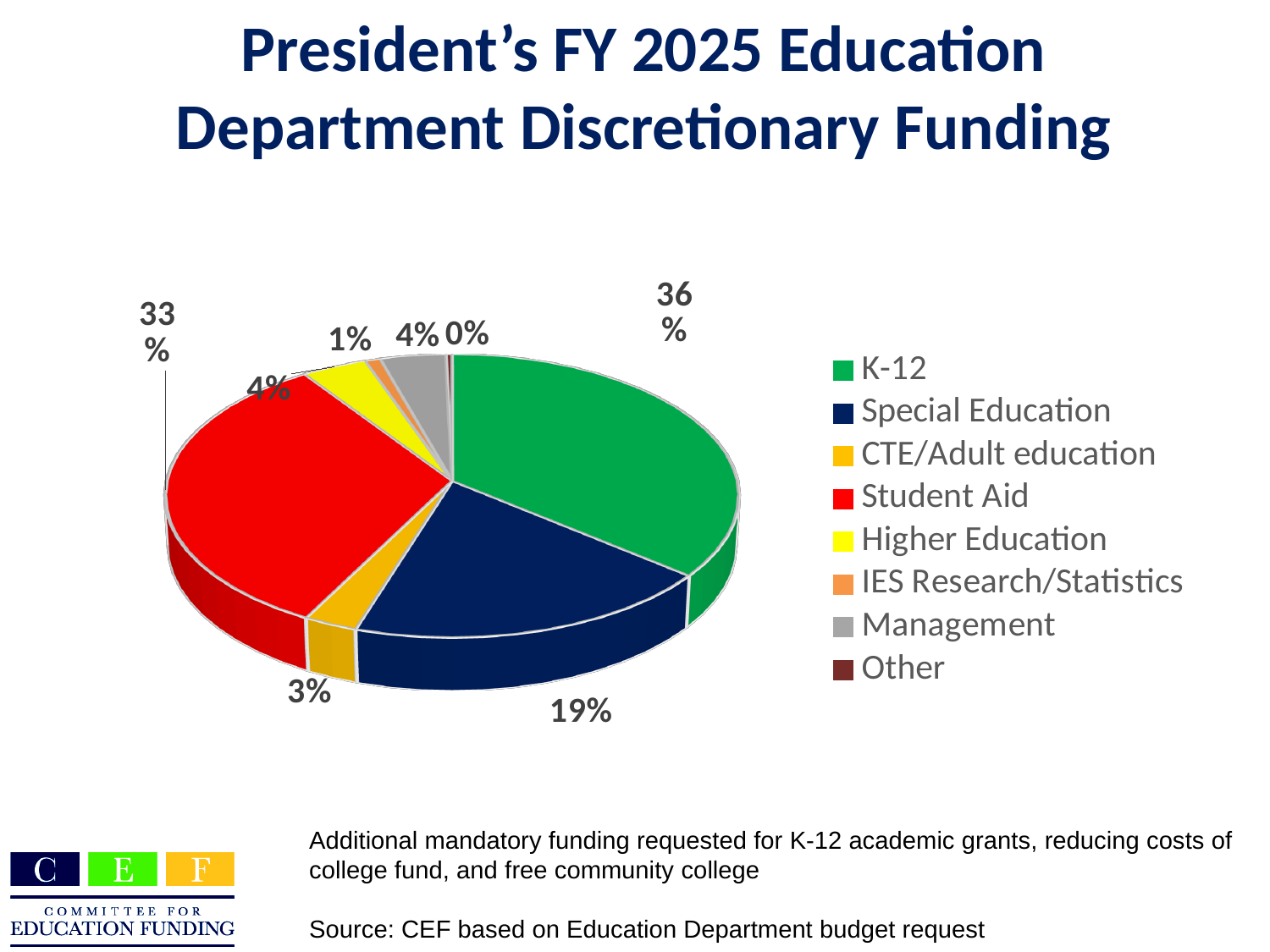
How many percentage points larger is the K-12 share than the Student Aid share? 3 What type of chart is shown on the slide? Pie chart Which category has the largest share of the pie? K-12 What percentage is shown for Special Education? 19% What percentage is shown for Other? 0% What share of the pie does K-12 represent? 36% What percentage is shown for Student Aid? 33% What percentage is shown for CTE/Adult education? 3% What percentage is shown for IES Research/Statistics? 1% Which is larger, the share for Special Education or the share for Student Aid? Student Aid How many categories does the legend list? 8 Which category has the smallest share of the pie? Other